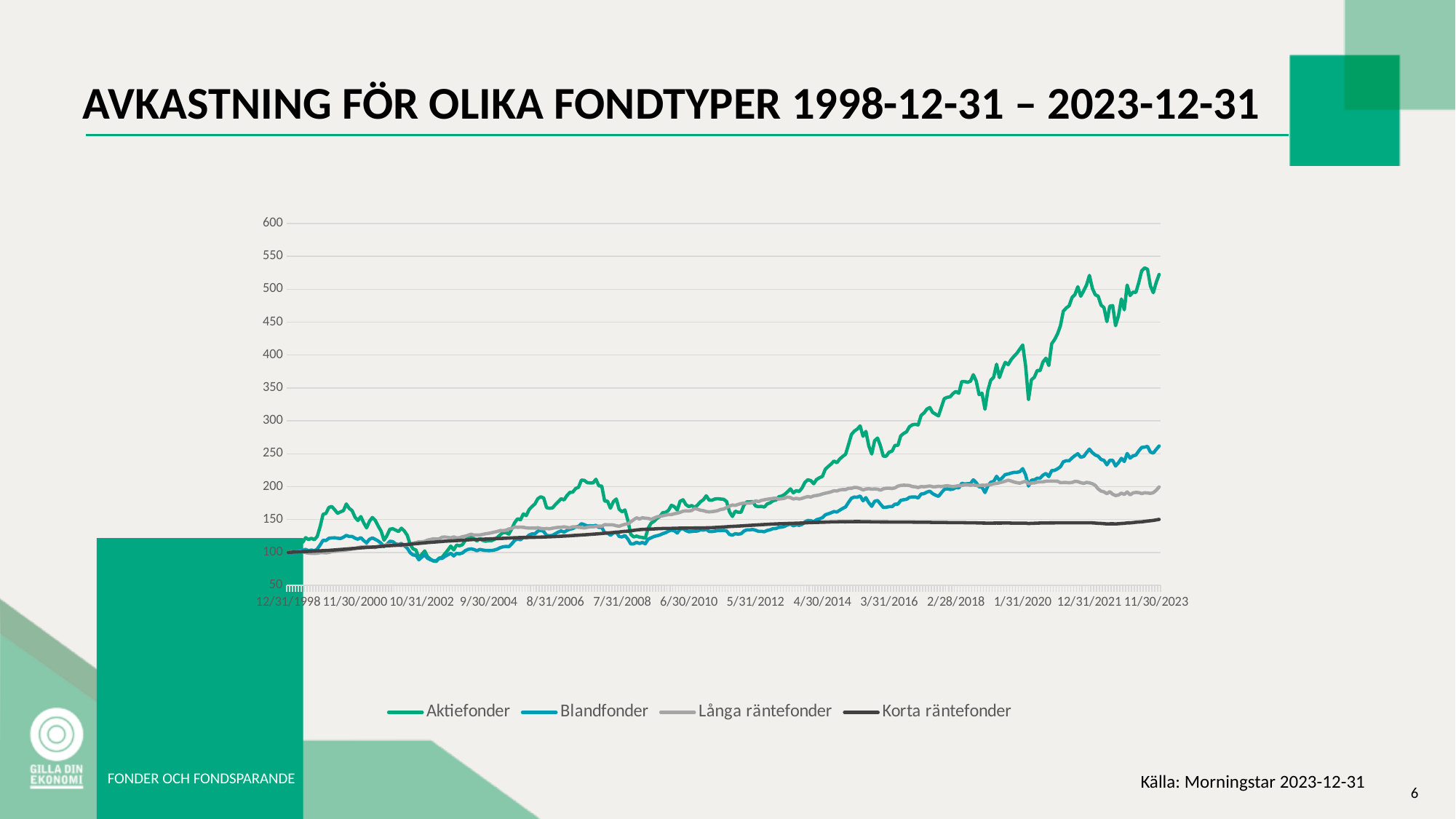
Which series is drawn as the dark grey/black line in the legend? Korta räntefonder Is the value for Aktiefonder at the end of the period greater or less than 500? greater Is the value for Långa räntefonder at the end of the period greater or less than 250? less What is the title of the chart on the slide? AVKASTNING FÖR OLIKA FONDTYPER 1998-12-31 – 2023-12-31 What kind of chart is shown on the slide? line chart Which series has the lowest value at the end of the period (11/30/2023)? Korta räntefonder Which series has the highest value at the end of the period (11/30/2023)? Aktiefonder Does the Aktiefonder series rise or fall overall from 1998 to 2023? rise Is the value for Korta räntefonder at the end of the period greater or less than 200? less How many series does the legend list? 4 At the end of the period, which is higher: Blandfonder or Långa räntefonder? Blandfonder